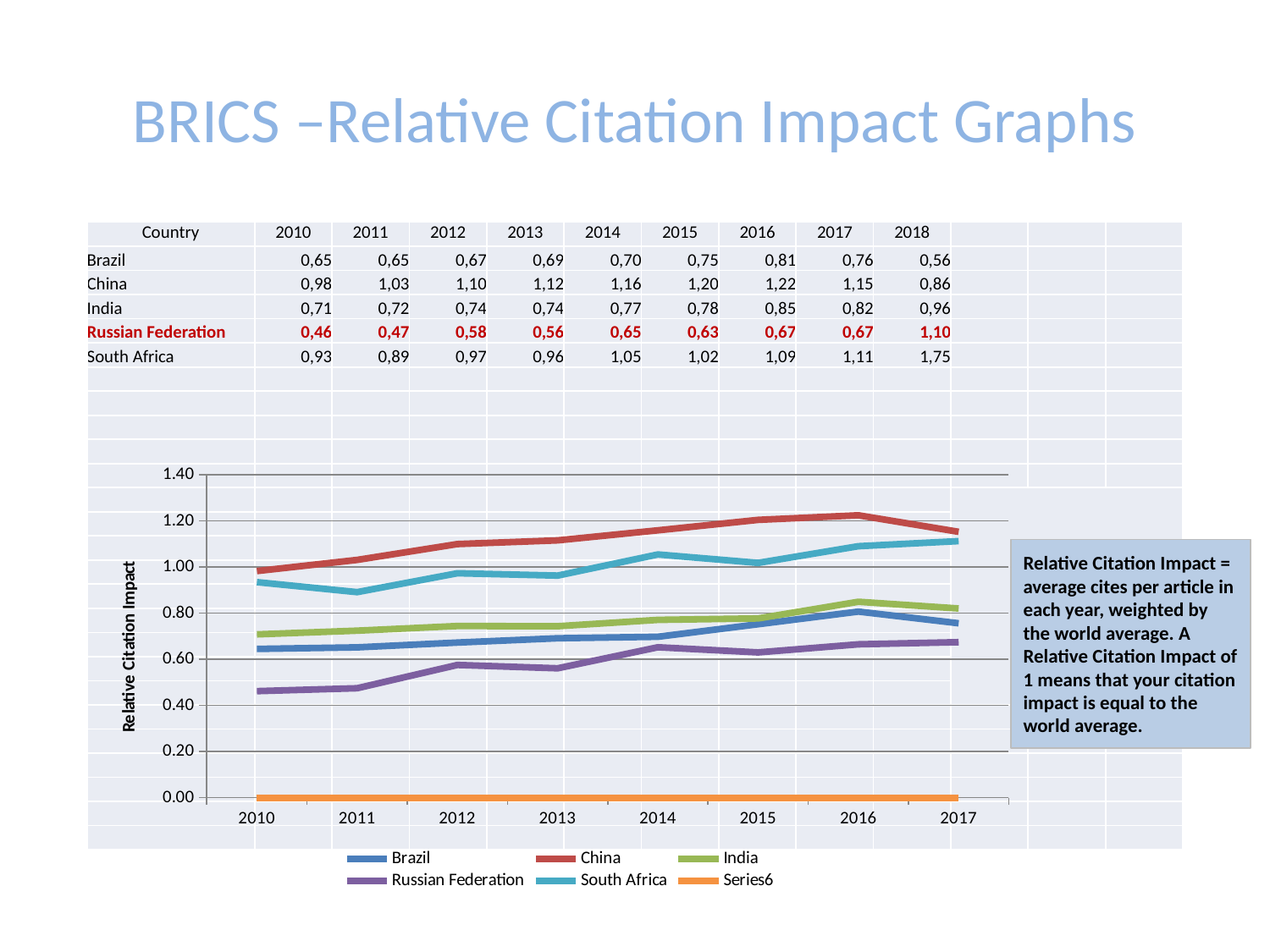
What is the Relative Citation Impact for the Russian Federation in 2010? 0,46 What is the Relative Citation Impact for South Africa in 2017? 1,11 What is the difference between China's and Brazil's Relative Citation Impact in 2016? 0,41 How many series does the chart legend list? 6 Which country has the highest Relative Citation Impact in 2016? China Is the value for China in 2014 greater or less than 1.00? greater Which country has the lowest Relative Citation Impact in 2010? Russian Federation Does the Russian Federation line rise or fall overall from 2010 to 2017? rise How many years are plotted along the x axis of the chart? 8 In 2014, which has the larger Relative Citation Impact, South Africa or India? South Africa What is the Relative Citation Impact for China in 2016? 1,22 What kind of chart is shown on the slide? line chart